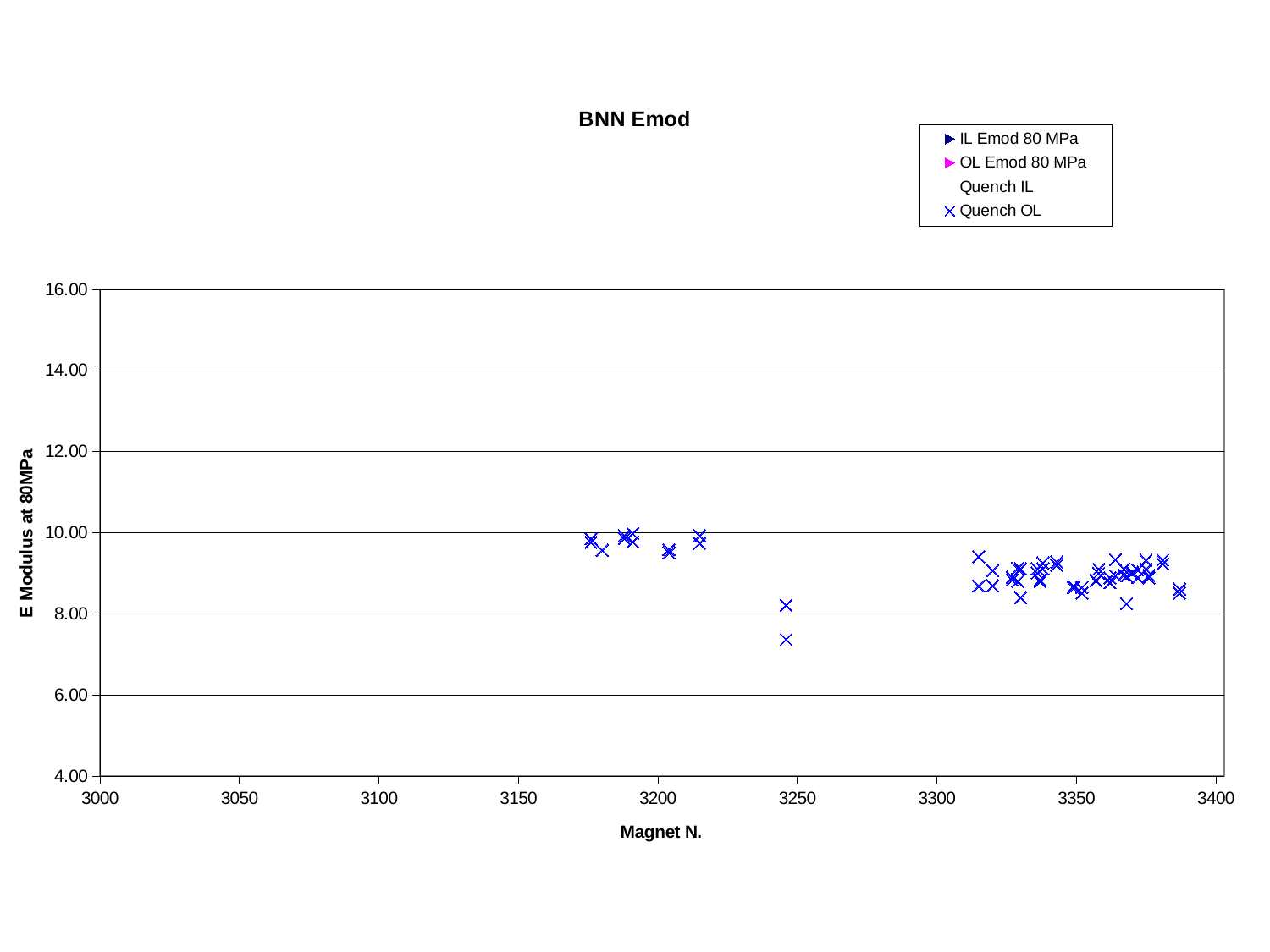
Are the plotted values in the cluster around magnet number 3350 generally higher or lower than those in the cluster around magnet number 3190? lower Is the lowest plotted point, near magnet number 3250, greater or less than 8.00? less What is the x-axis title of the chart? Magnet N. Near which x-axis tick value does the lowest plotted point appear? 3250 What kind of chart is shown on the slide? scatter chart Are the plotted points near magnet number 3350 greater or less than 12.00? less How many series does the legend of the BNN Emod chart list? 4 What is the title of the chart? BNN Emod Are the plotted points near magnet number 3190 greater or less than 8.00? greater Do the plotted values generally rise or fall moving from the cluster near 3190 to the cluster near 3350 along the x axis? fall